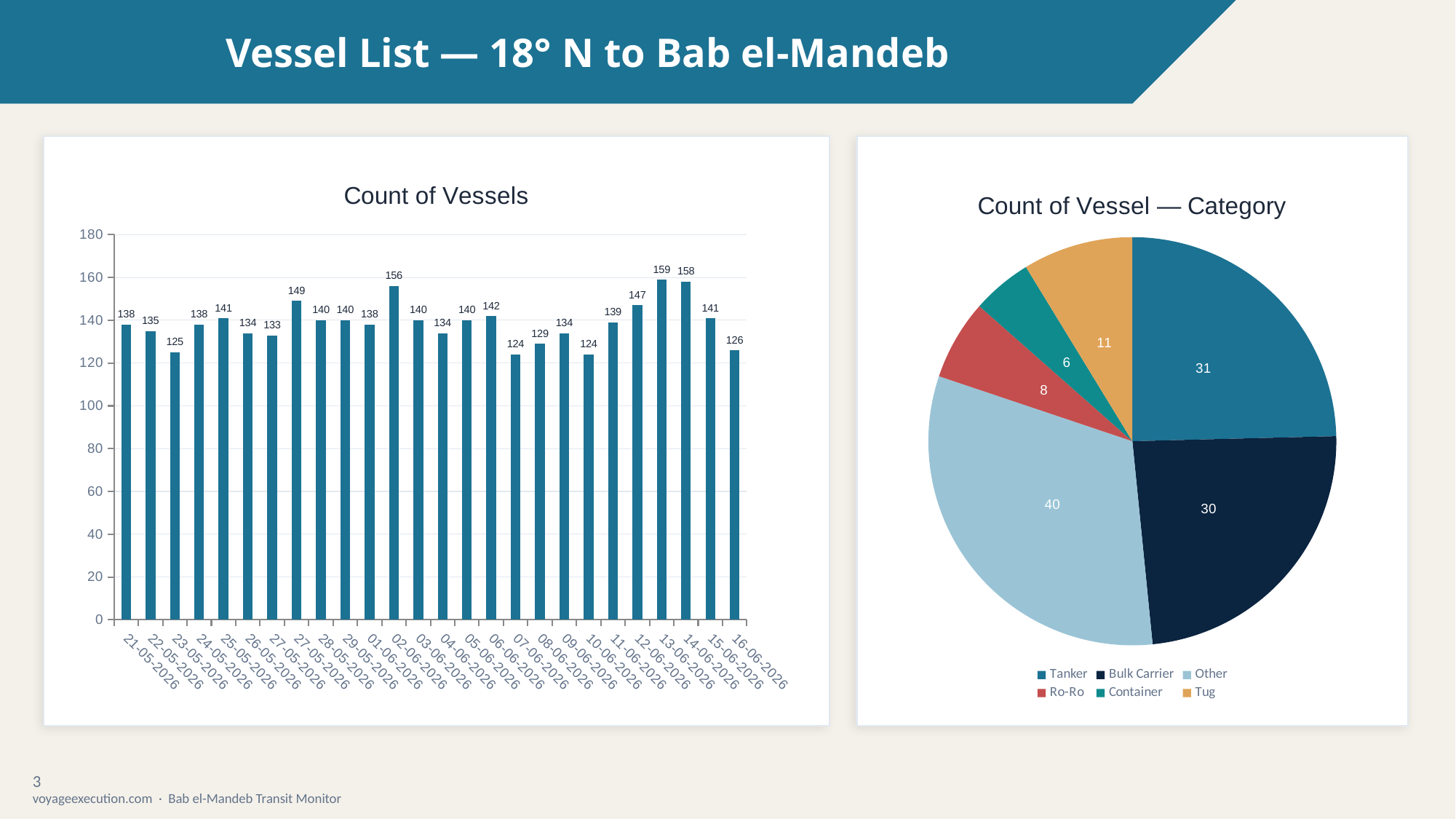
In the "Count of Vessels" chart, which date has the highest count? 13-06-2026 In the "Count of Vessel — Category" pie chart, which category has the smallest slice? Container How many bars are plotted in the "Count of Vessels" chart? 26 In the "Count of Vessel — Category" pie chart, which category has the largest slice? Other In the "Count of Vessels" chart, what is the value for 02-06-2026? 156 In the "Count of Vessel — Category" pie chart, what is the total of all slices? 126 In the "Count of Vessels" chart, is the value for 23-05-2026 greater or less than 140? less What kind of chart is the "Count of Vessels" chart on the left? bar chart In the "Count of Vessels" chart, what is the value for 12-06-2026? 147 In the "Count of Vessel — Category" pie chart, what is the value for Tanker? 31 How many categories does the legend of the "Count of Vessel — Category" pie chart list? 6 In the "Count of Vessels" chart, what is the difference between the values for 13-06-2026 and 16-06-2026? 33